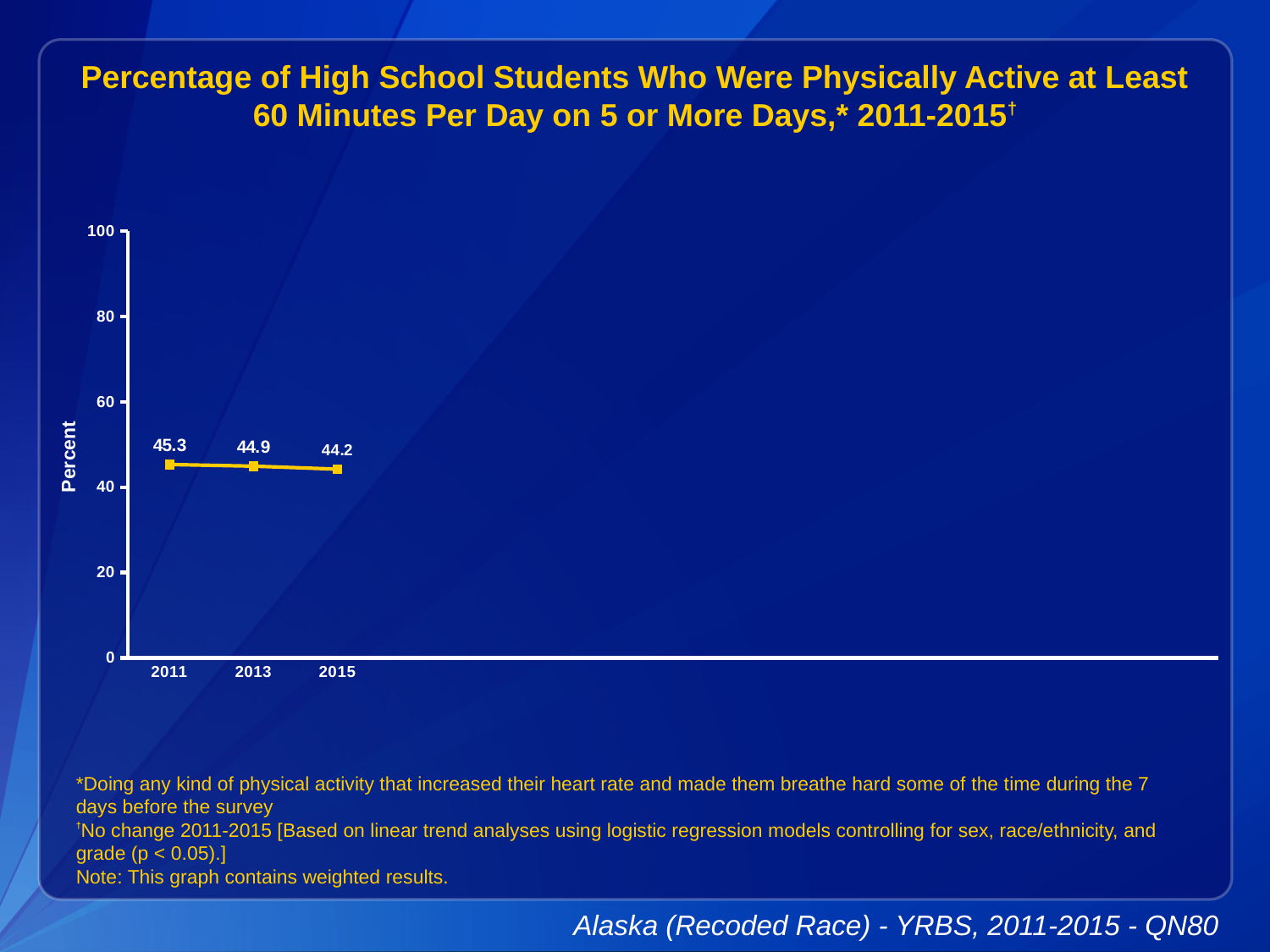
What is the difference between the 2011 and 2015 values? 1.1 Which year has the lowest value? 2015 What is the value for 2015? 44.2 What is the label on the y axis? Percent What is the value for 2013? 44.9 Is the value for 2015 greater or less than 60? less How many years are plotted on the chart? 3 Do the values rise or fall from 2011 to 2015? fall Which is larger, the value for 2011 or the value for 2013? 2011 Which year has the highest value? 2011 What kind of chart is shown? line chart What is the value for 2011? 45.3